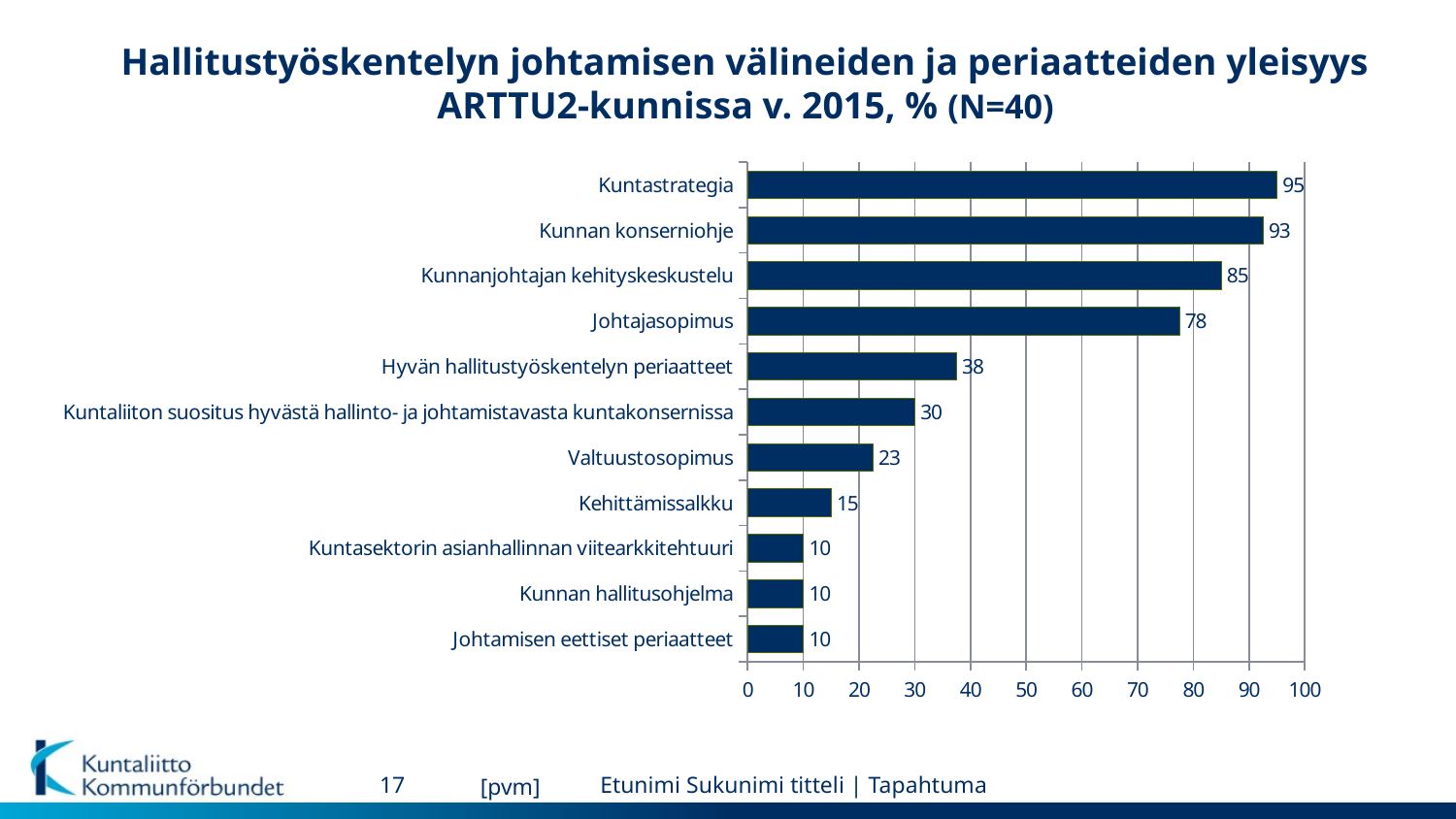
How many categories have a value of 10? 3 How many categories are shown in the chart? 11 Which is larger, the value for Johtajasopimus or the value for Hyvän hallitustyöskentelyn periaatteet? Johtajasopimus What is the difference between the values for Kunnan konserniohje and Kunnanjohtajan kehityskeskustelu? 8 Is the value for Kunnanjohtajan kehityskeskustelu greater or less than 80? greater What is the value for Valtuustosopimus? 23 What is the difference between the values for Hyvän hallitustyöskentelyn periaatteet and Kuntaliiton suositus hyvästä hallinto- ja johtamistavasta kuntakonsernissa? 8 What kind of chart is shown on the slide? Bar chart What is the value for Johtajasopimus? 78 Which category has the highest value? Kuntastrategia What is the value for Kehittämissalkku? 15 What is the value for Kuntastrategia? 95